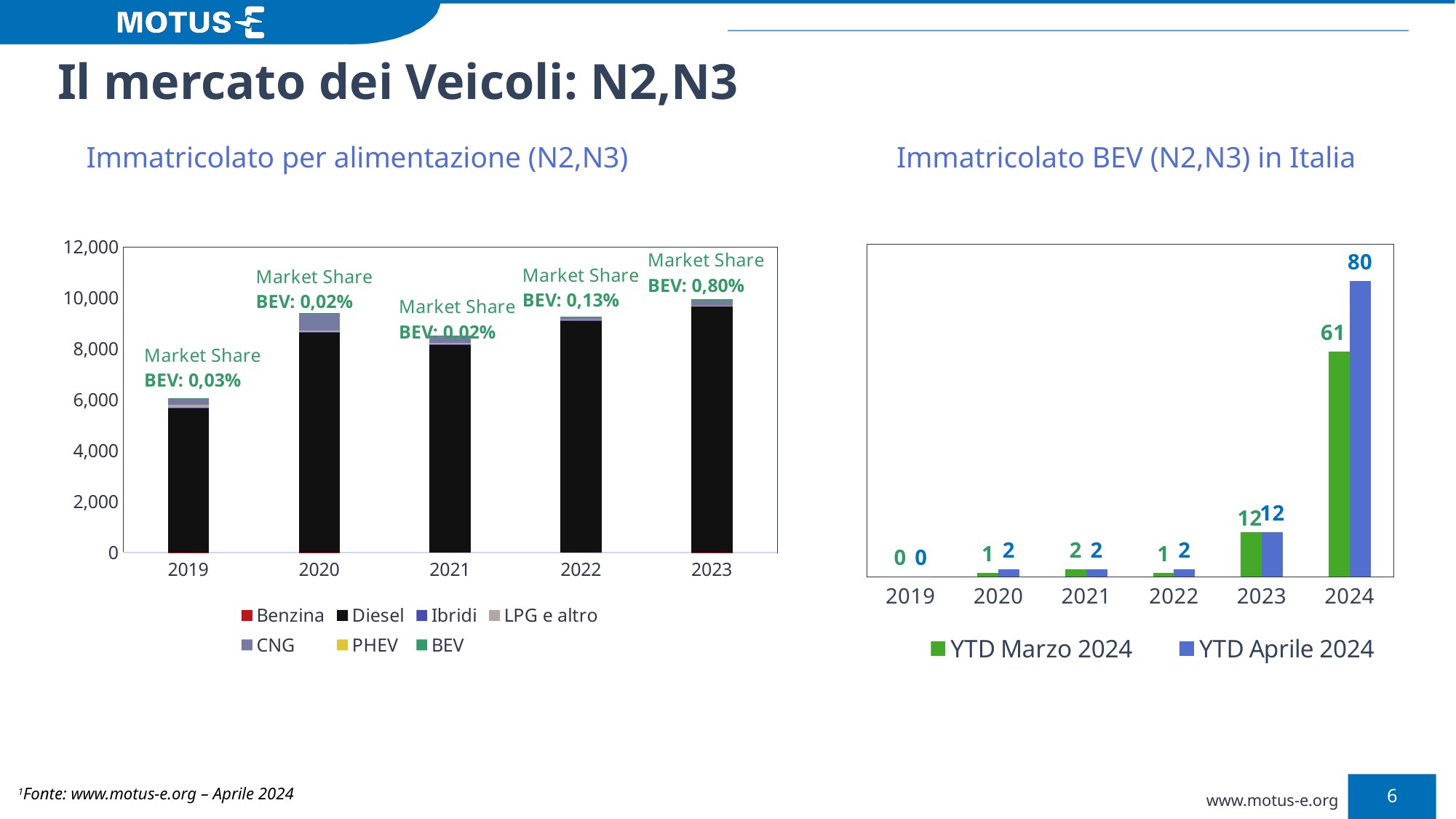
In the chart 'Immatricolato BEV (N2,N3) in Italia', what is the value for YTD Marzo 2024 in 2020? 1 In the chart 'Immatricolato per alimentazione (N2,N3)', is the total for 2019 greater or less than 8,000? less What kind of chart is 'Immatricolato BEV (N2,N3) in Italia'? bar chart In the chart 'Immatricolato per alimentazione (N2,N3)', what BEV market share is shown for 2023? 0,80% In the chart 'Immatricolato BEV (N2,N3) in Italia', how many years are shown on the x axis? 6 In the chart 'Immatricolato BEV (N2,N3) in Italia', what is the value for YTD Aprile 2024 in 2024? 80 In the chart 'Immatricolato BEV (N2,N3) in Italia', what is the value for YTD Marzo 2024 in 2024? 61 In the chart 'Immatricolato BEV (N2,N3) in Italia', which year has the highest YTD Aprile 2024 value? 2024 In the chart 'Immatricolato BEV (N2,N3) in Italia', what is the difference between YTD Aprile 2024 and YTD Marzo 2024 in 2024? 19 In the chart 'Immatricolato BEV (N2,N3) in Italia', how many series does the legend list? 2 In the chart 'Immatricolato per alimentazione (N2,N3)', which year has a larger total, 2019 or 2020? 2020 In the chart 'Immatricolato per alimentazione (N2,N3)', how many series does the legend list? 7